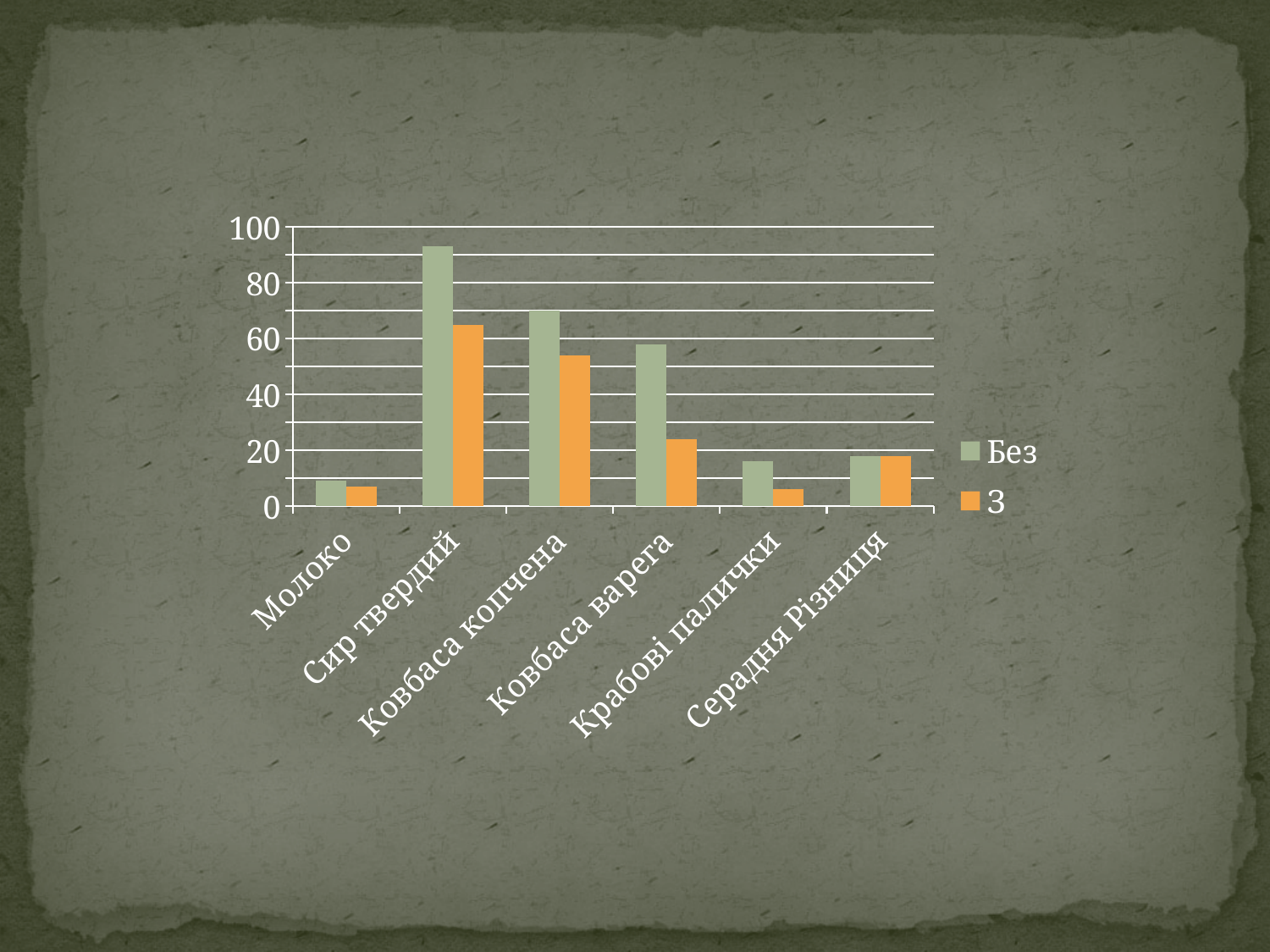
Which category has the highest value for the З series? Сир твердий Is the value for Ковбаса копчена in the Без series greater or less than 60? greater For Ковбаса варега, which series has the larger value, Без or З? Без Which category has the highest value for the Без series? Сир твердий Which category has the lowest value for the Без series? Молоко How many categories are shown on the x axis of the chart? 6 What are the two series named in the legend? Без and З What kind of chart is shown on the slide? bar chart Which series is shown in orange in the chart? З Is the value for Ковбаса варега in the З series greater or less than 40? less Is the value for Сир твердий in the Без series greater or less than 80? greater How many series does the chart's legend list? 2